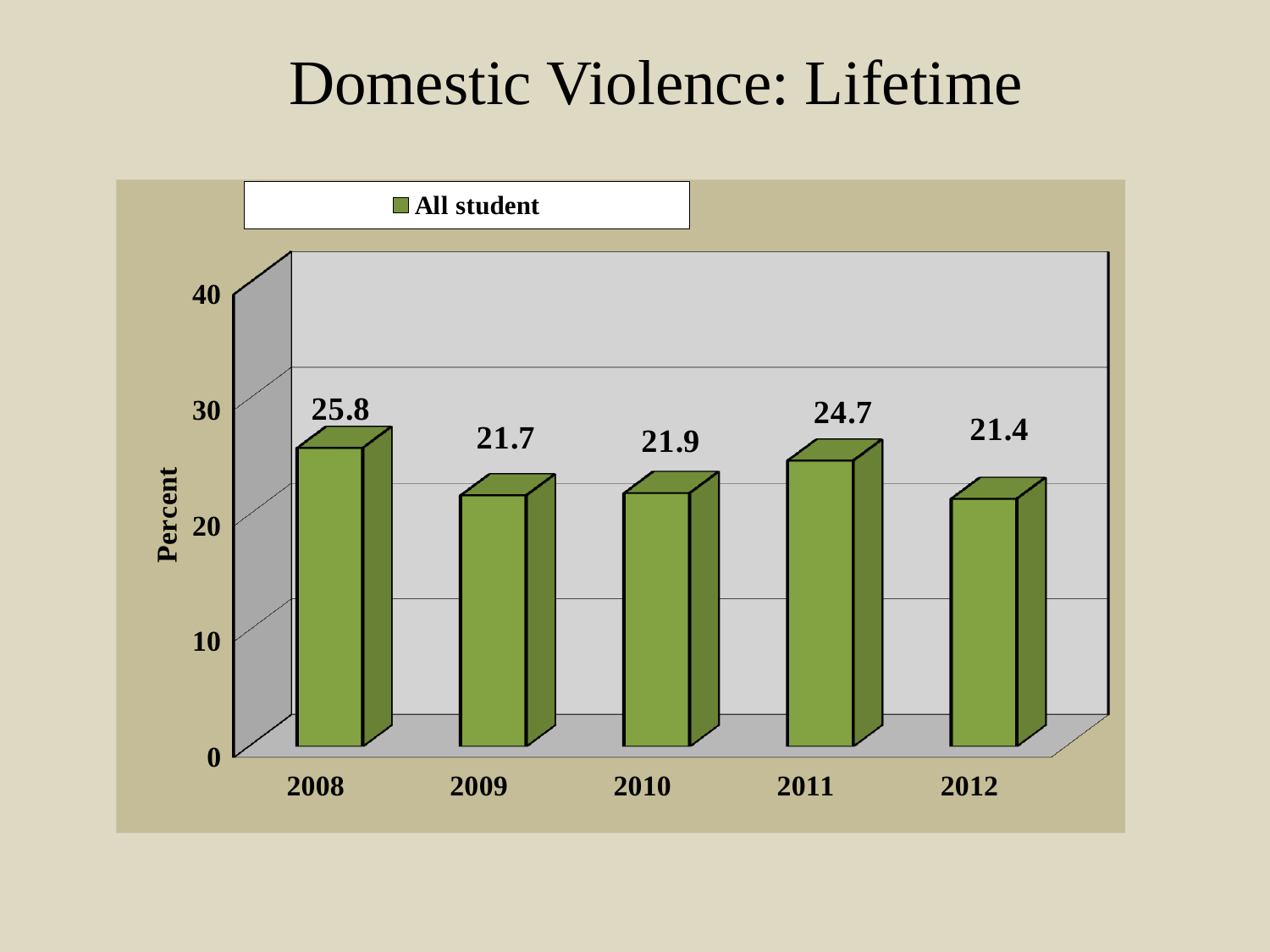
Which year has the lowest value? 2012 Which is larger, the value for 2010 or the value for 2011? 2011 What kind of chart is shown? bar chart Which year has the highest value? 2008 What is the value for 2008? 25.8 What is the difference between the values for 2008 and 2009? 4.1 What is the value for 2011? 24.7 How many years are shown on the x axis? 5 What is the difference between the values for 2011 and 2012? 3.3 Is the value for 2009 greater or less than 30? less What is the value for 2012? 21.4 What series does the legend list? All student